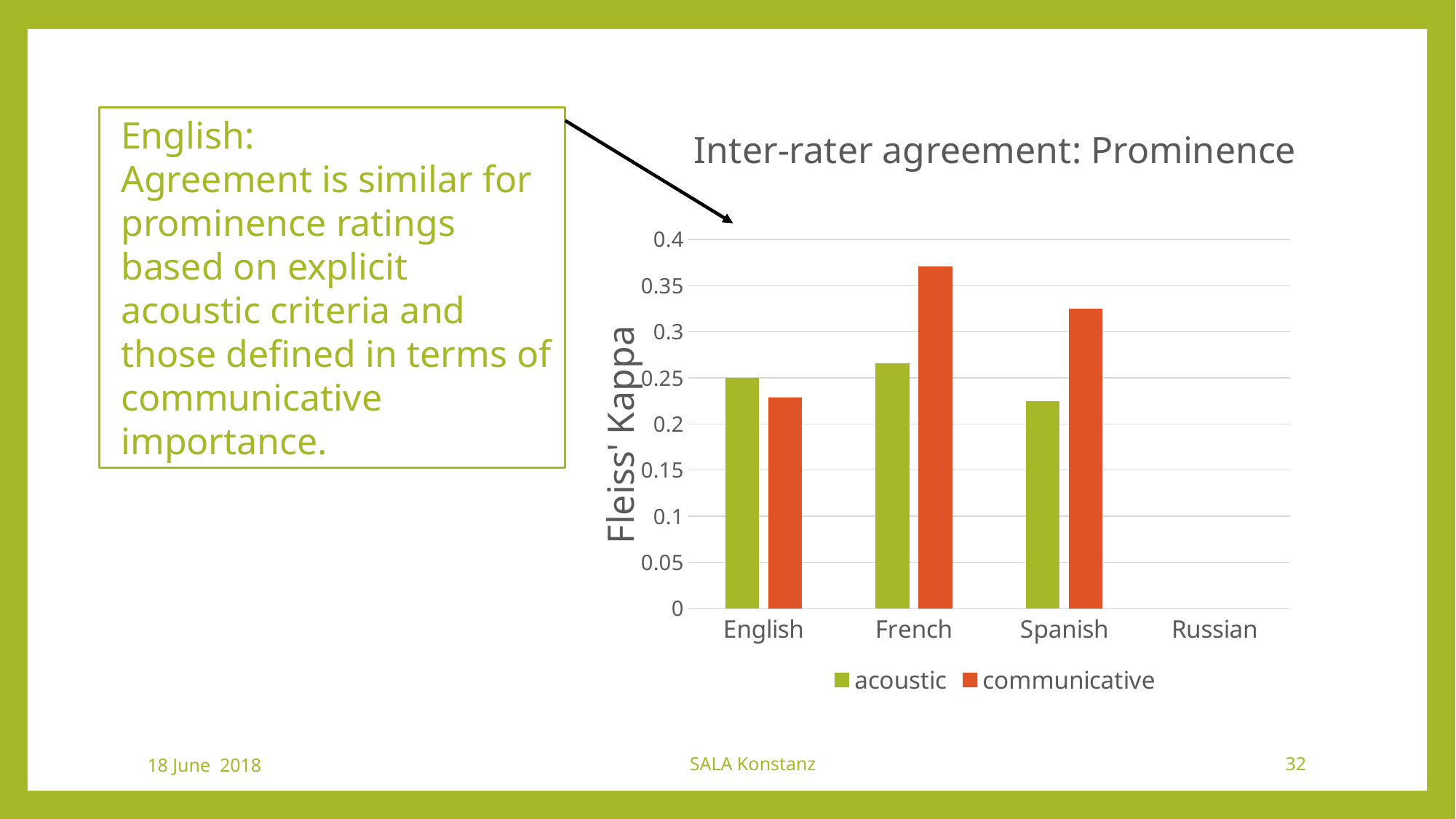
Which language has the highest communicative value? French What kind of chart is shown on the slide? bar chart What is the label on the y axis? Fleiss' Kappa Is the acoustic value for Spanish greater or less than 0.25? less How many series does the legend list? 2 Is the communicative value for French greater or less than 0.35? greater For English, which is larger: the acoustic or the communicative value? acoustic Is the communicative value for Spanish greater or less than 0.3? greater Which language has the lowest acoustic value among those with bars shown? Spanish What is the title of the chart? Inter-rater agreement: Prominence For French, which is larger: the acoustic or the communicative value? communicative How many language categories are shown on the x axis? 4